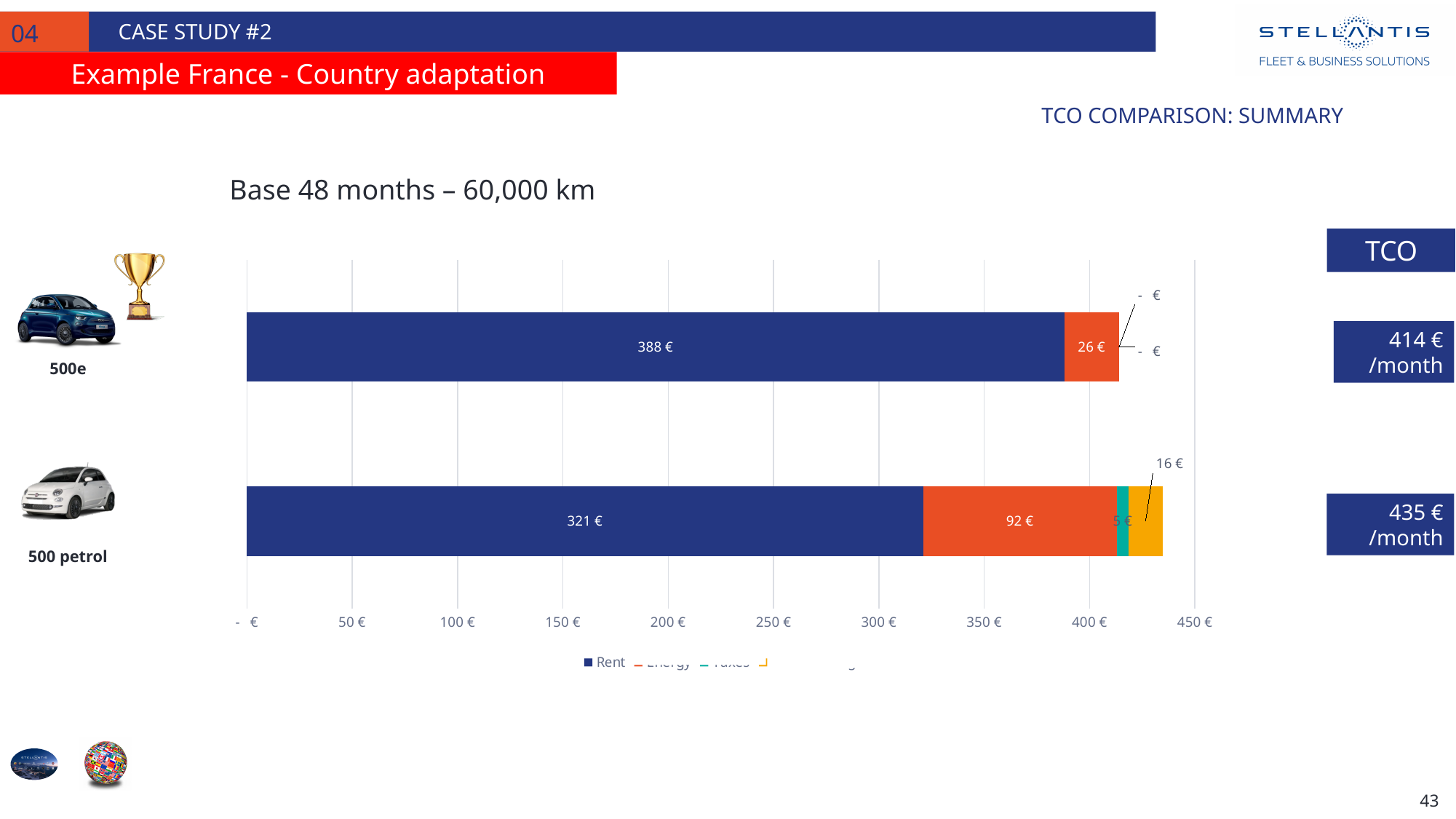
What is the Rent value for the 500 petrol? 321 € What is the Energy value for the 500e? 26 € What is the Rent value for the 500e? 388 € What is the difference between the Energy values of the 500 petrol and the 500e? 66 € What is the total monthly TCO shown for the 500e? 414 €/month How many vehicles (categories) are compared in the chart? 2 What is the Energy value for the 500 petrol? 92 € Is the Rent value for the 500 petrol greater or less than 350 €? less What kind of chart is shown on the slide? Stacked bar chart What is the difference between the Rent values of the 500e and the 500 petrol? 67 € Which vehicle has the higher Rent value, the 500e or the 500 petrol? 500e What is the Taxes value for the 500 petrol? 5 €